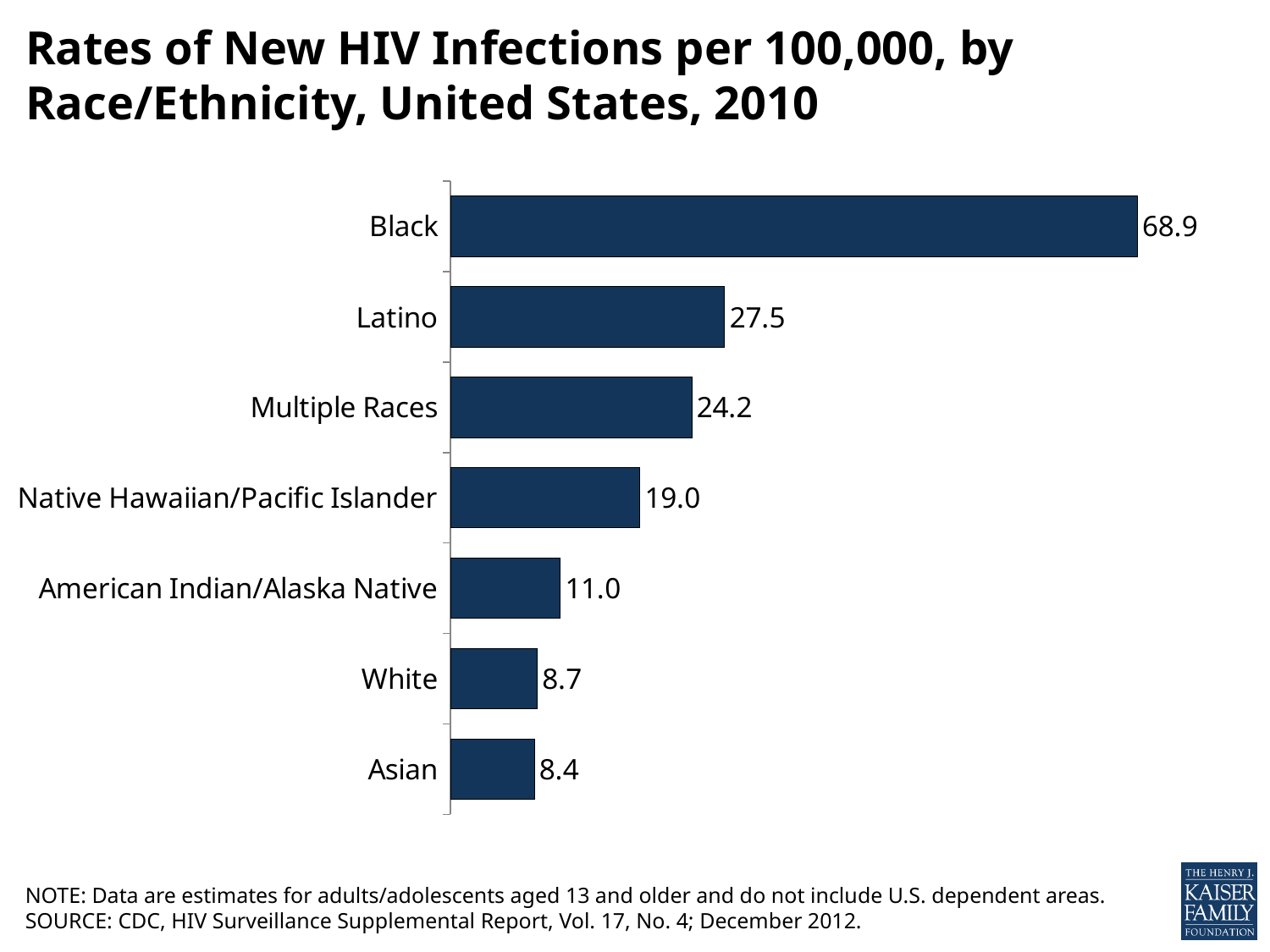
Which has a higher rate of new HIV infections, Latino or Multiple Races? Latino Which race/ethnicity has the lowest rate of new HIV infections? Asian What kind of chart is shown on the slide? Bar chart What is the rate of new HIV infections per 100,000 for Native Hawaiian/Pacific Islander individuals? 19.0 What is the rate of new HIV infections per 100,000 for Latino individuals? 27.5 What is the difference between the rates for Multiple Races and American Indian/Alaska Native? 13.2 How many race/ethnicity categories are shown in the chart? 7 What is the title of the chart? Rates of New HIV Infections per 100,000, by Race/Ethnicity, United States, 2010 What is the rate of new HIV infections per 100,000 for Black individuals? 68.9 Which race/ethnicity has the highest rate of new HIV infections? Black What is the difference between the rates for Black and Latino individuals? 41.4 What is the rate of new HIV infections per 100,000 for White individuals? 8.7